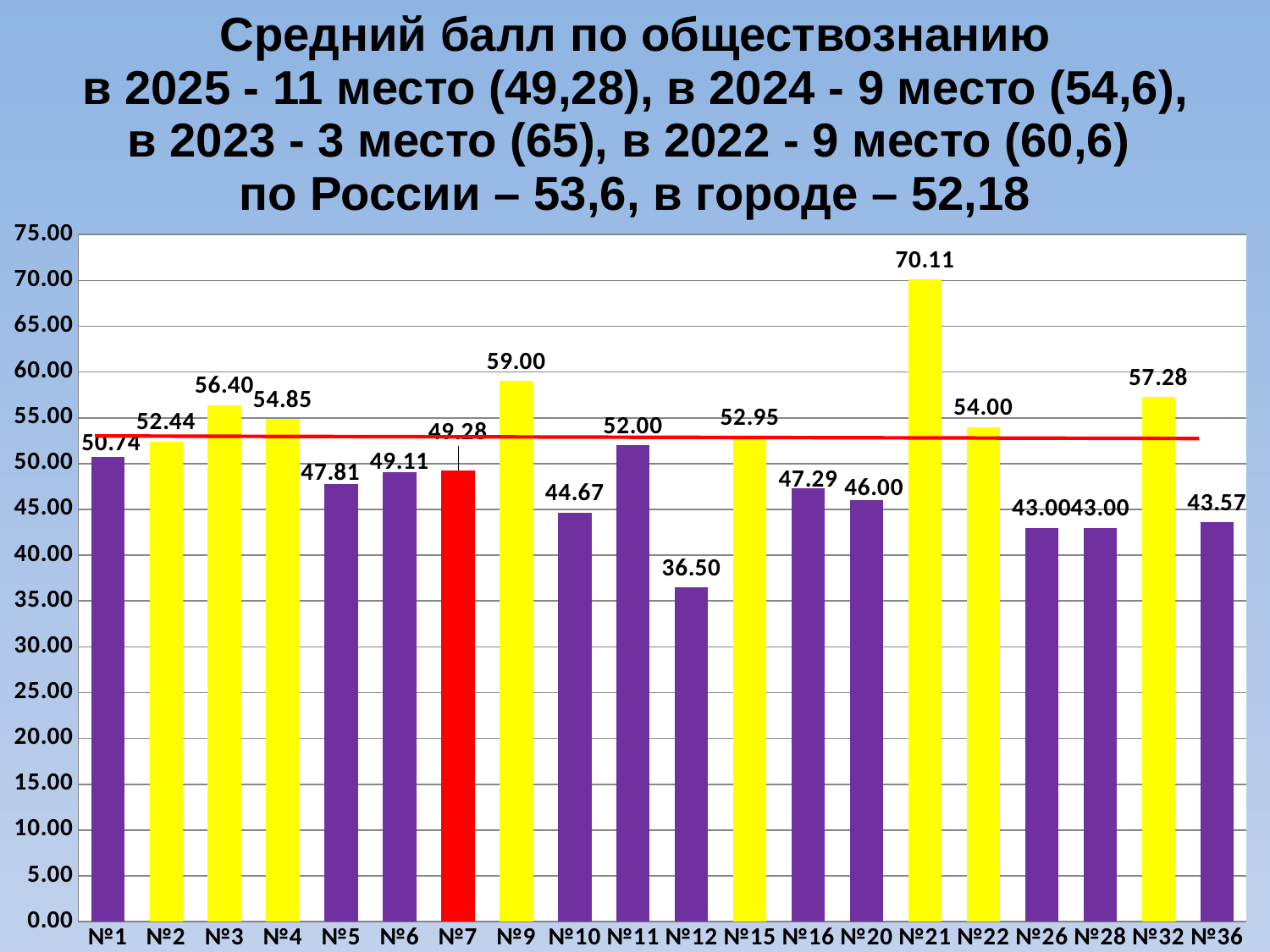
How many categories are shown on the x axis? 20 What is the difference between the values for №21 and №12? 33.61 What is the difference between the values for №9 and №7? 9.72 What is the value for №7? 49.28 Is the value for №12 greater or less than 40.00? less Which category has the lowest value? №12 What type of chart is shown on the slide? bar chart What is the value for №21? 70.11 Which category's bar is coloured red? №7 Which is larger, the value for №1 or the value for №2? №2 Which category has the highest value? №21 What is the value for №12? 36.50